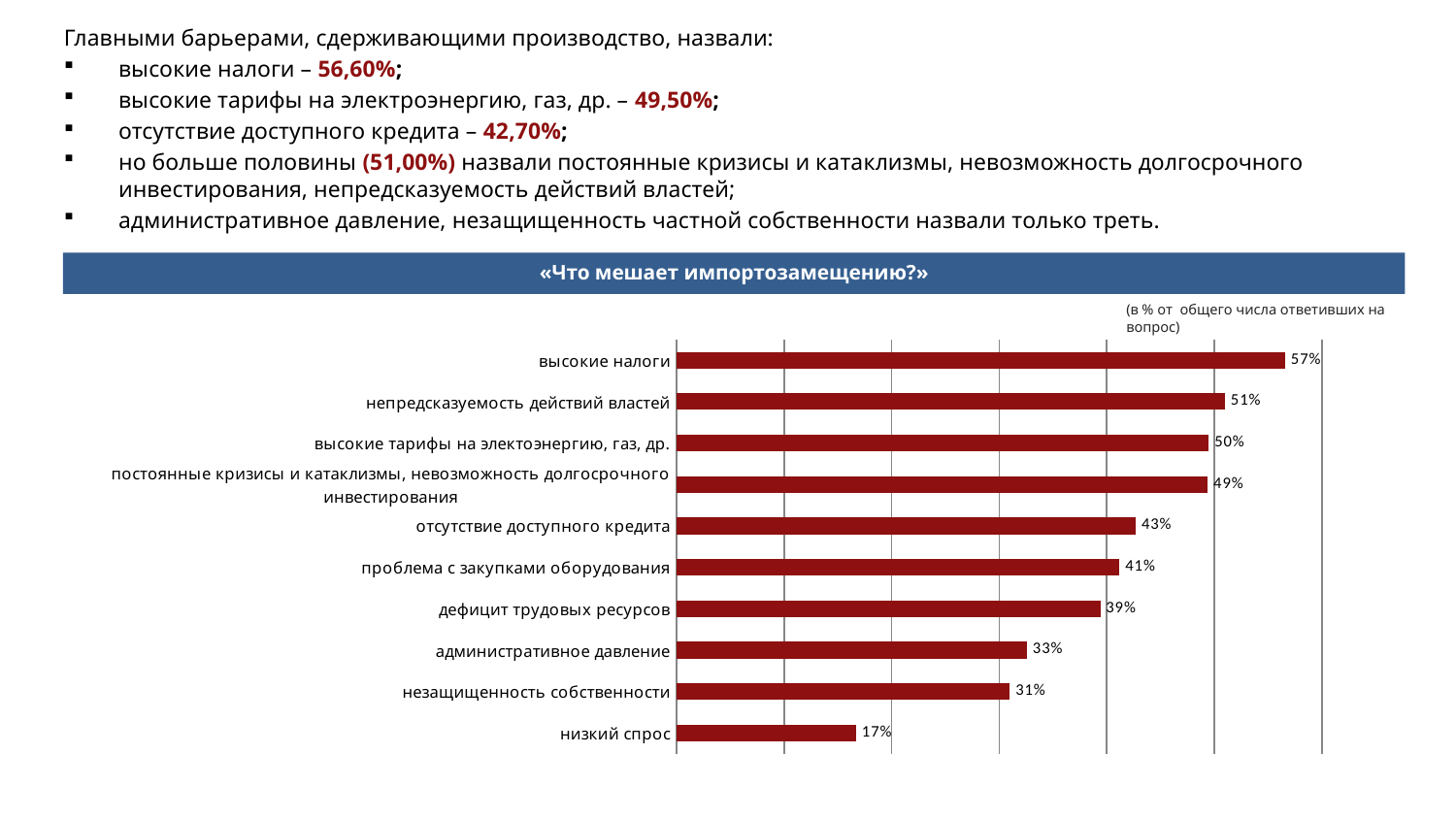
Which category has the lowest value in the chart? низкий спрос What is the difference between the values for «высокие налоги» and «низкий спрос»? 40% What is the value for «высокие налоги» in the chart? 57% What is the value for «низкий спрос» in the chart? 17% What is the value for «административное давление»? 33% How many categories are shown in the chart? 10 What is the title of the chart? «Что мешает импортозамещению?» What is the value for «отсутствие доступного кредита»? 43% Which is larger: the value for «проблема с закупками оборудования» or the value for «незащищенность собственности»? проблема с закупками оборудования What kind of chart is shown on the slide? bar chart What is the difference between the values for «непредсказуемость действий властей» and «дефицит трудовых ресурсов»? 12% Which category has the highest value in the chart? высокие налоги